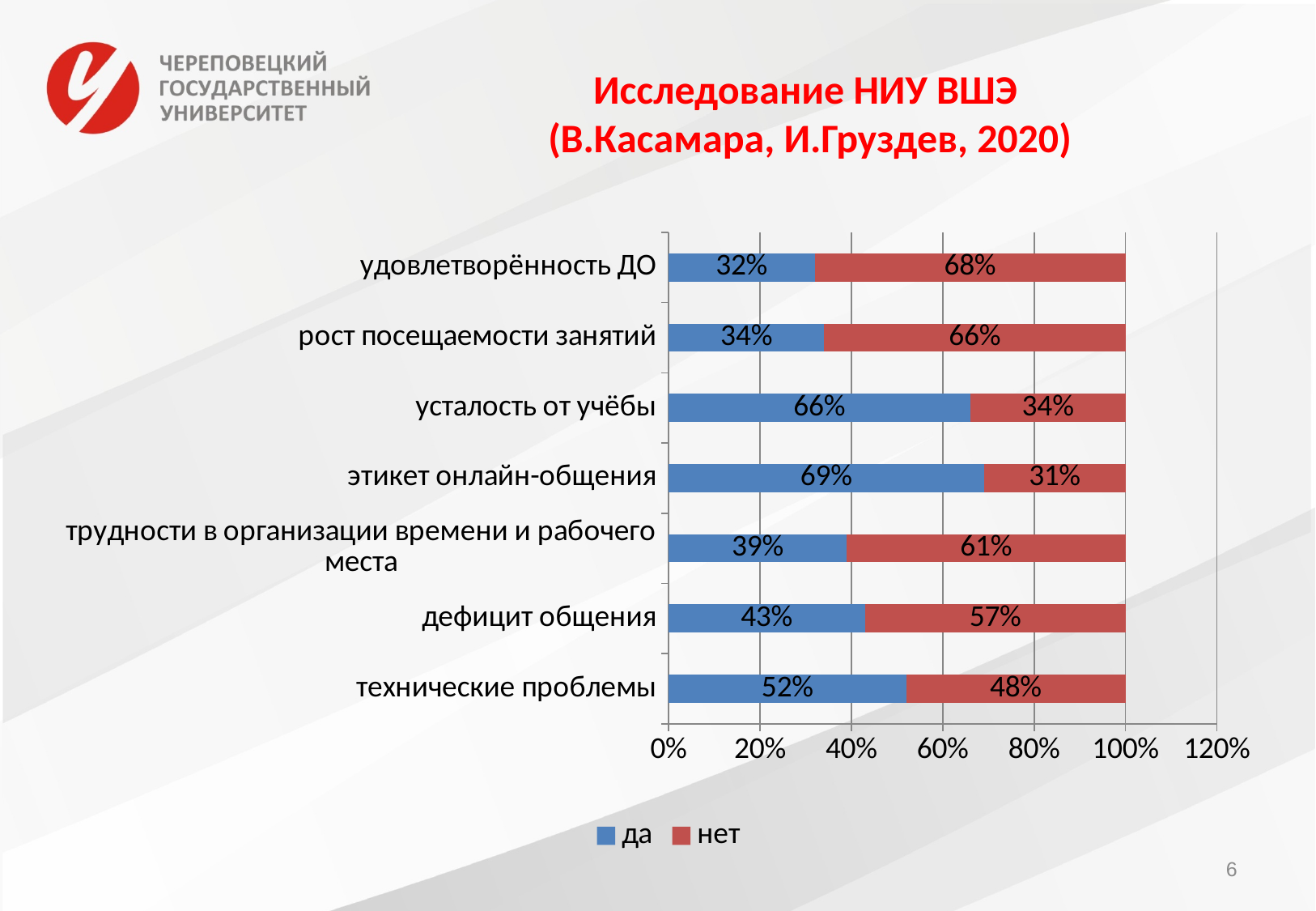
What kind of chart is shown on the slide? stacked bar chart How many categories are shown on the chart? 7 How many series does the legend list? 2 What is the difference between the "нет" and "да" values for "дефицит общения"? 14% What is the "да" value for "технические проблемы"? 52% Which category has the lowest "да" value? удовлетворённость ДО What is the "да" value for "этикет онлайн-общения"? 69% Which category has the highest "да" value? этикет онлайн-общения What is the total of the stacked bar for "рост посещаемости занятий"? 100% Which is larger for "усталость от учёбы": the "да" value or the "нет" value? да What is the "нет" value for "трудности в организации времени и рабочего места"? 61% What is the "нет" value for "удовлетворённость ДО"? 68%